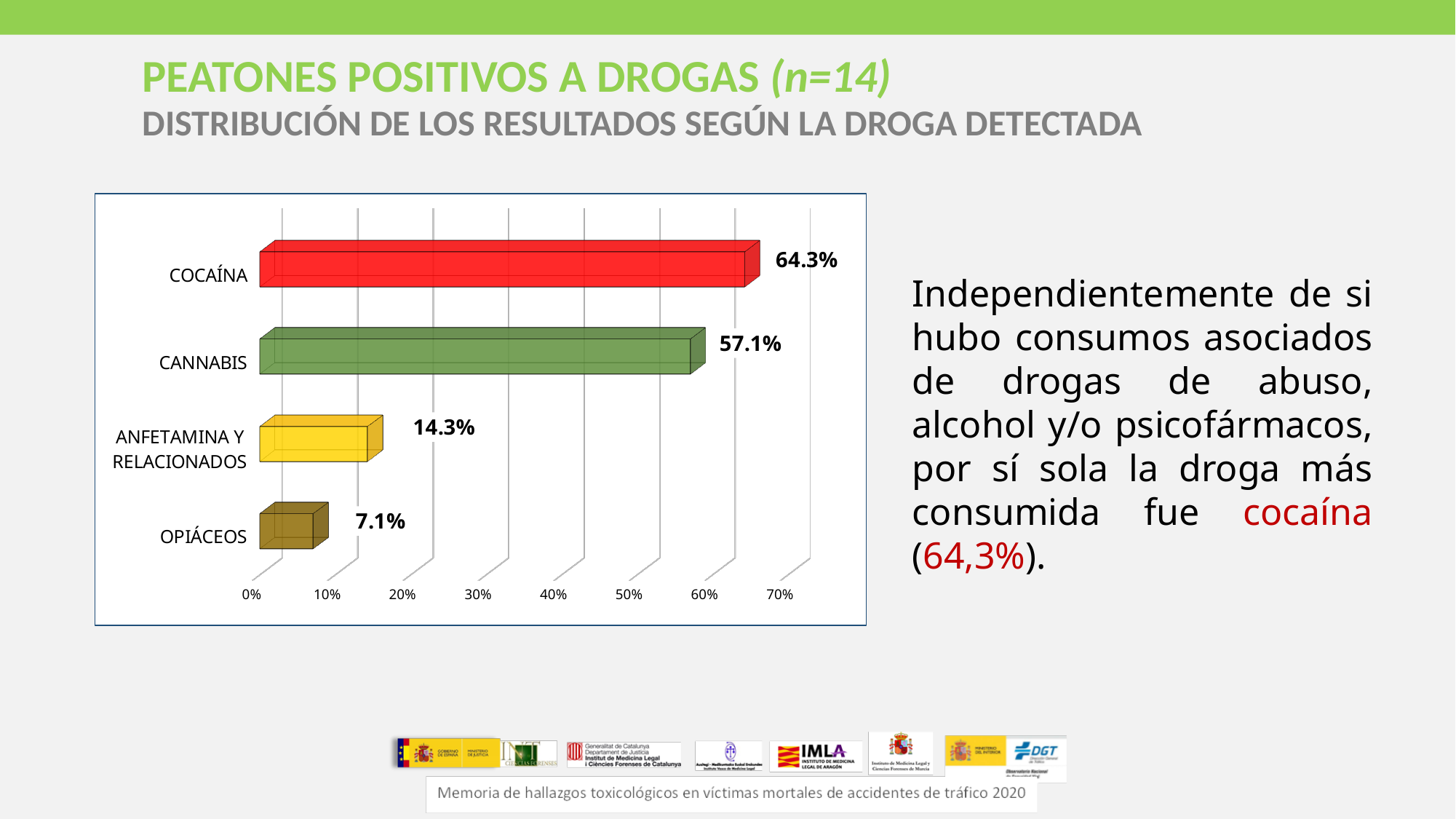
Which category has the lowest value? OPIÁCEOS What kind of chart is shown on the slide? bar chart What is the value for OPIÁCEOS? 7.1% How many categories are shown in the chart? 4 Which is larger, the value for ANFETAMINA Y RELACIONADOS or the value for OPIÁCEOS? ANFETAMINA Y RELACIONADOS What is the value for COCAÍNA? 64.3% Is the value for CANNABIS greater or less than 50%? greater What is the value for ANFETAMINA Y RELACIONADOS? 14.3% What is the difference between the values for COCAÍNA and CANNABIS? 7.2% What is the value for CANNABIS? 57.1% What colour is the bar for CANNABIS? green Which category has the highest value? COCAÍNA